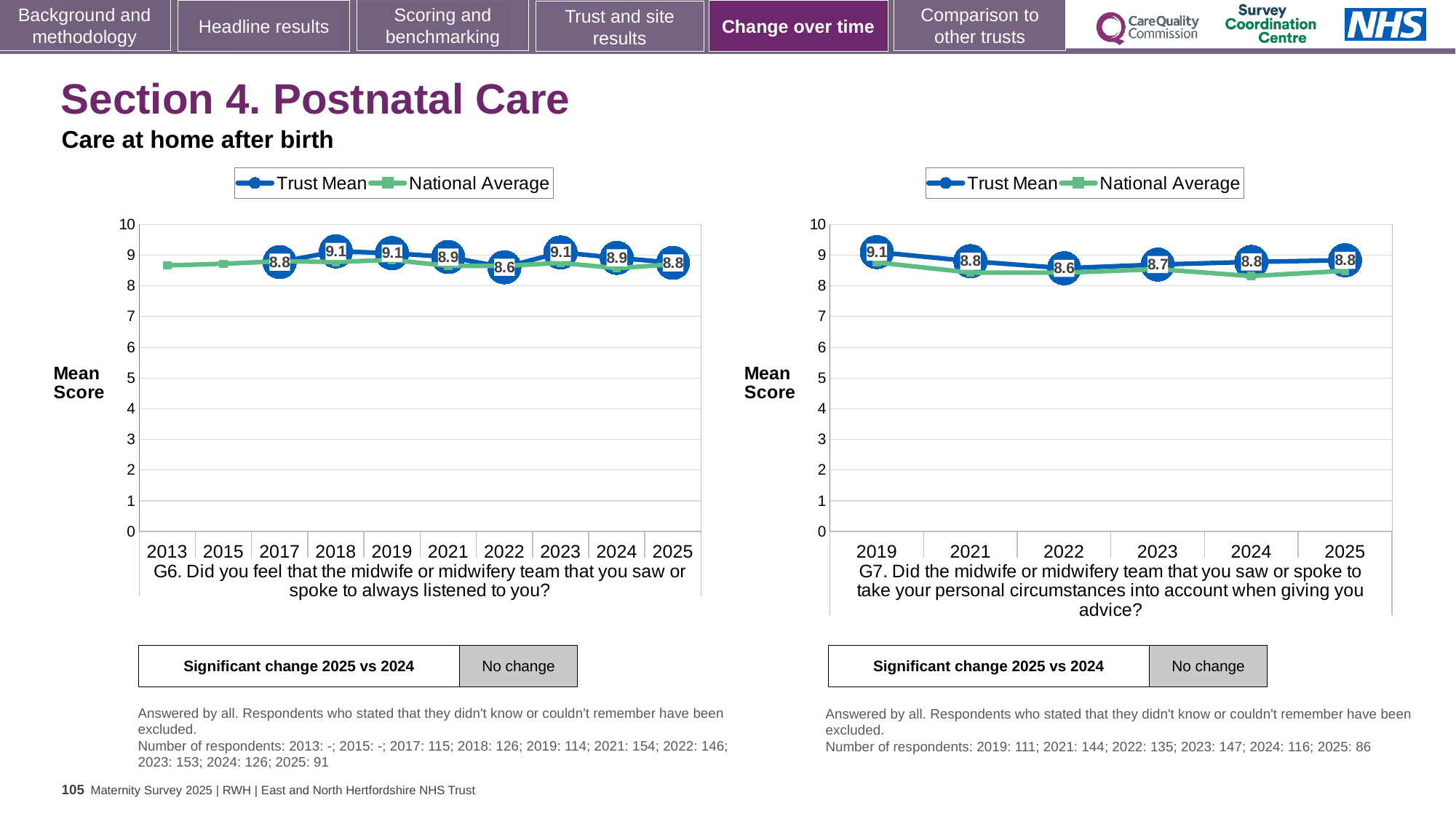
In the right chart (G7), what is the Trust Mean for 2023? 8.7 In the left chart (G6), what is the Trust Mean for 2018? 9.1 In the left chart (G6), what is the difference between the Trust Mean in 2018 and in 2022? 0.5 In the right chart (G7), which year has the lowest Trust Mean? 2022 How many series does the legend of the right chart (G7) list? 2 In the right chart (G7), what is the Trust Mean for 2019? 9.1 In the left chart (G6), which year has the lowest Trust Mean? 2022 In the right chart (G7), which year has the highest Trust Mean? 2019 In the right chart (G7), is the National Average for 2024 greater or less than 9? less In the left chart (G6), what is the Trust Mean for 2025? 8.8 In the right chart (G7), is the Trust Mean higher in 2019 or in 2025? 2019 How many years are shown on the x axis of the left chart (G6)? 10